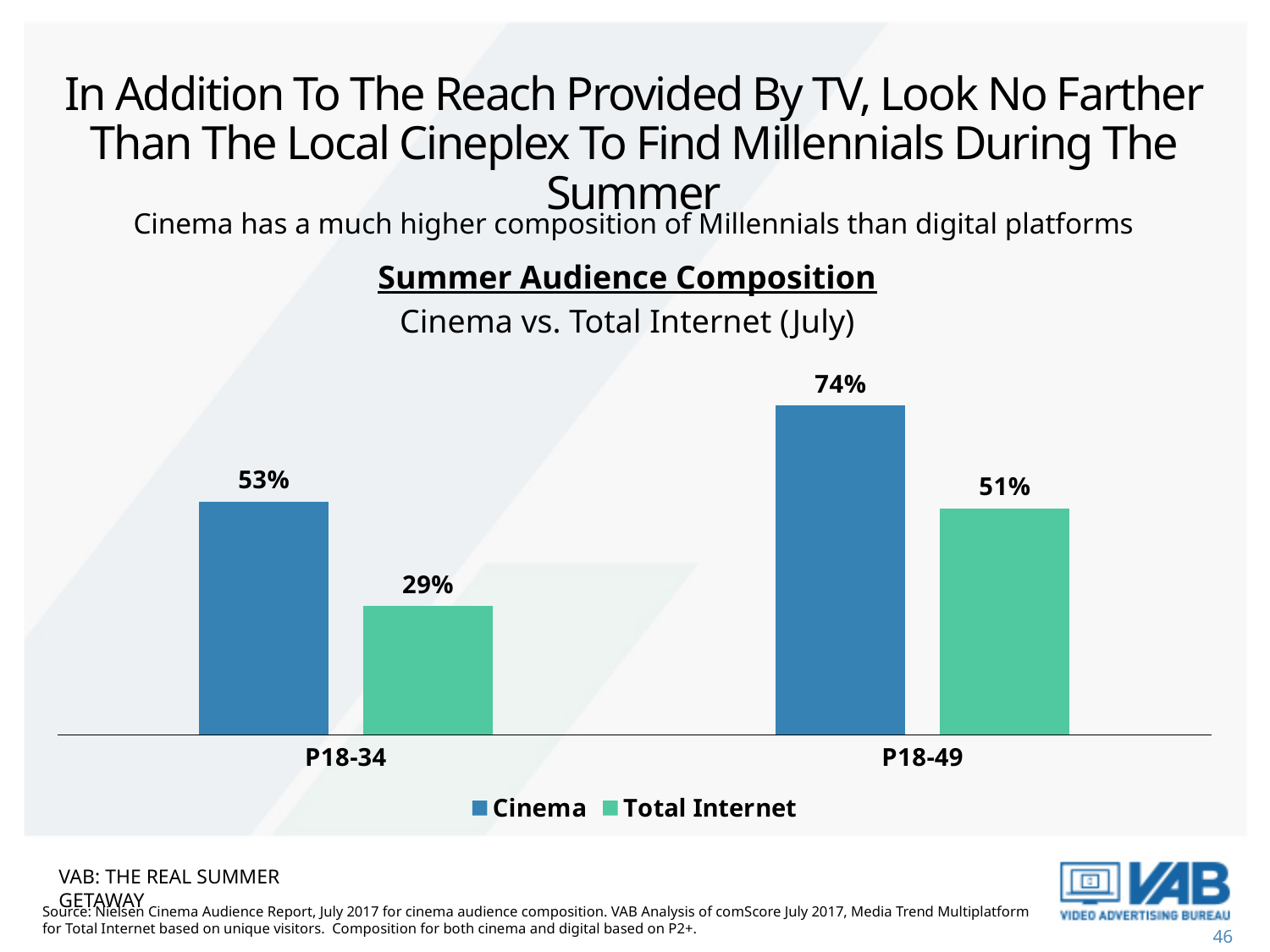
What is the Total Internet value for P18-49? 51% Which bar has the lowest value on the chart? Total Internet, P18-34 How many categories are shown on the x axis? 2 Which bar has the highest value on the chart? Cinema, P18-49 What is the difference between the Cinema and Total Internet values for P18-34? 24 percentage points What is the Cinema value for P18-34? 53% What kind of chart is shown on the slide? Bar chart How many series does the legend list? 2 What is the Total Internet value for P18-34? 29% For P18-49, which is larger: Cinema or Total Internet? Cinema What is the difference between the Cinema and Total Internet values for P18-49? 23 percentage points What is the Cinema value for P18-49? 74%